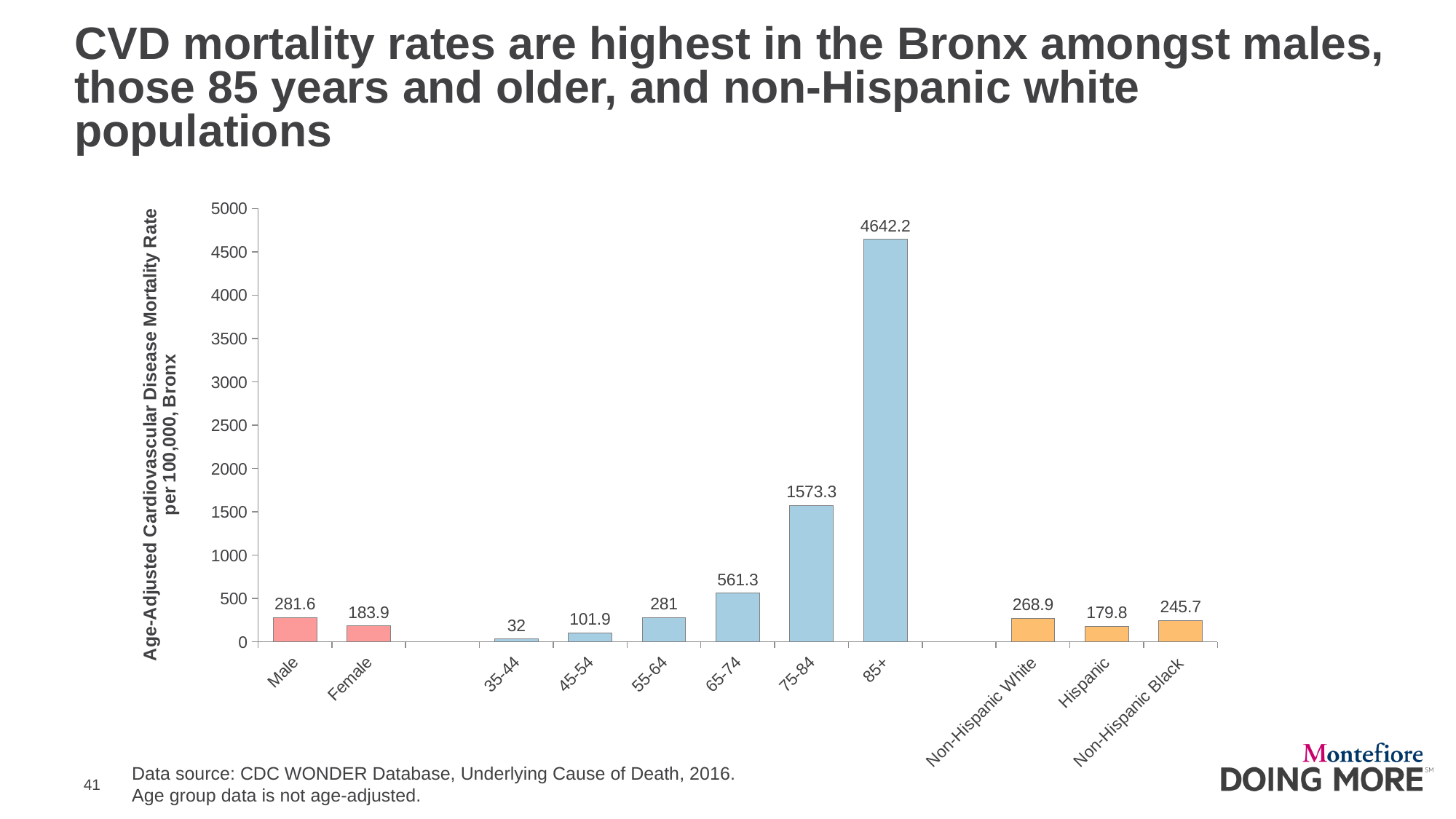
How many categories are plotted on the chart? 11 What is the CVD mortality rate for Hispanic? 179.8 Which category has the highest CVD mortality rate? 85+ What kind of chart is shown on the slide? bar chart Which has a higher CVD mortality rate, Non-Hispanic White or Non-Hispanic Black? Non-Hispanic White What is the CVD mortality rate for the 85+ age group? 4642.2 Which category has the lowest CVD mortality rate? 35-44 What is the difference between the 85+ and 75-84 CVD mortality rates? 3068.9 What is the difference between the Male and Female CVD mortality rates? 97.7 What is the CVD mortality rate for Male? 281.6 Do the values rise or fall across the age groups from 35-44 to 85+? rise Is the value for 65-74 greater or less than 500? greater